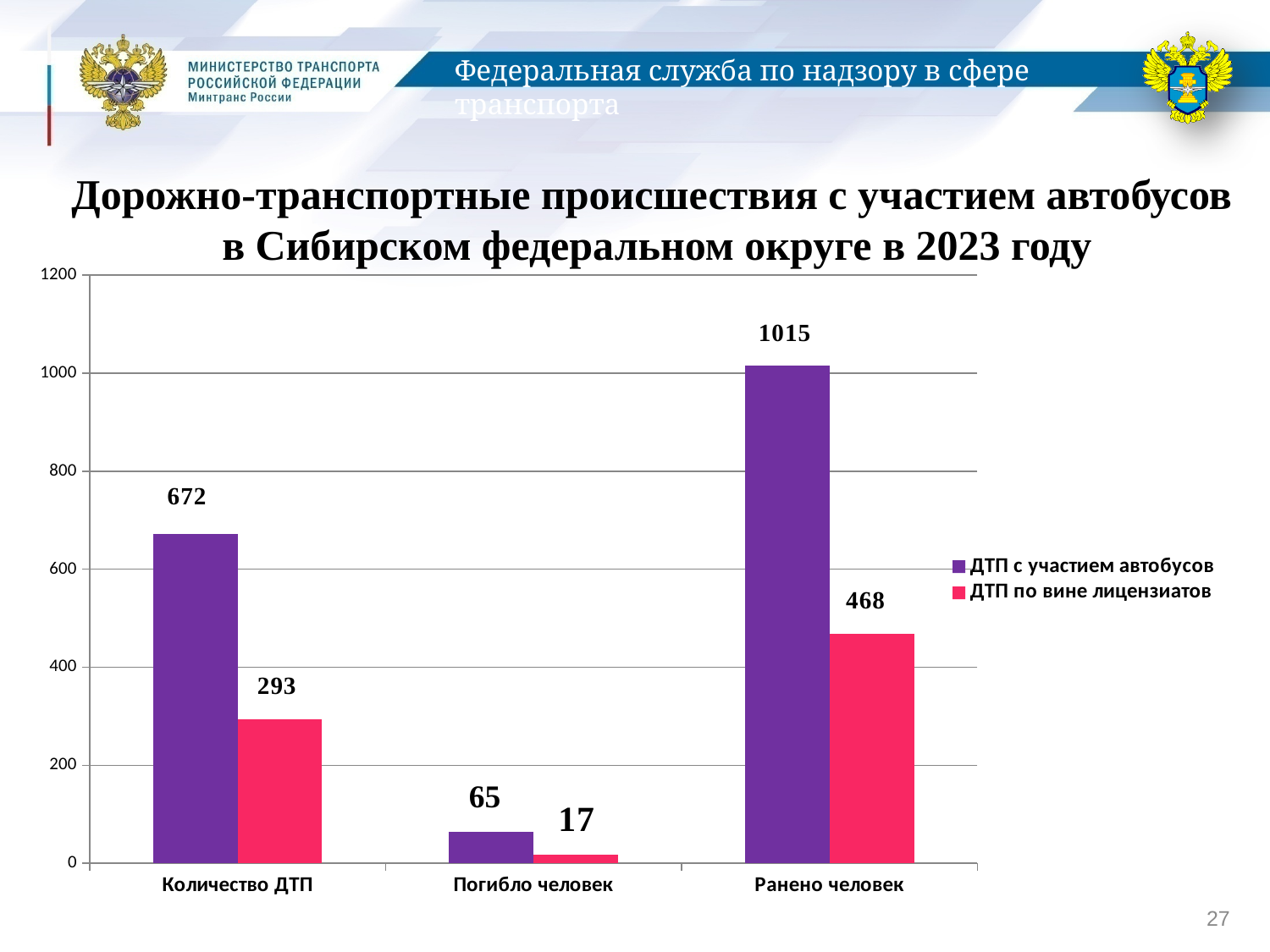
Which category has the lowest value in the «ДТП по вине лицензиатов» series? Погибло человек What is the value for «Погибло человек» in the «ДТП с участием автобусов» series? 65 Which category has the highest value in the «ДТП с участием автобусов» series? Ранено человек Which is larger: «Погибло человек» for «ДТП с участием автобусов» or «Погибло человек» for «ДТП по вине лицензиатов»? ДТП с участием автобусов What colour are the bars for the «ДТП по вине лицензиатов» series? Pink What is the difference between the two series for «Количество ДТП»? 379 How many categories are shown on the x axis? 3 What is the difference between the two series for «Ранено человек»? 547 What kind of chart is shown on the slide? Bar chart What is the value for «Ранено человек» in the «ДТП по вине лицензиатов» series? 468 How many series does the legend list? 2 What is the value for «Количество ДТП» in the «ДТП с участием автобусов» series? 672